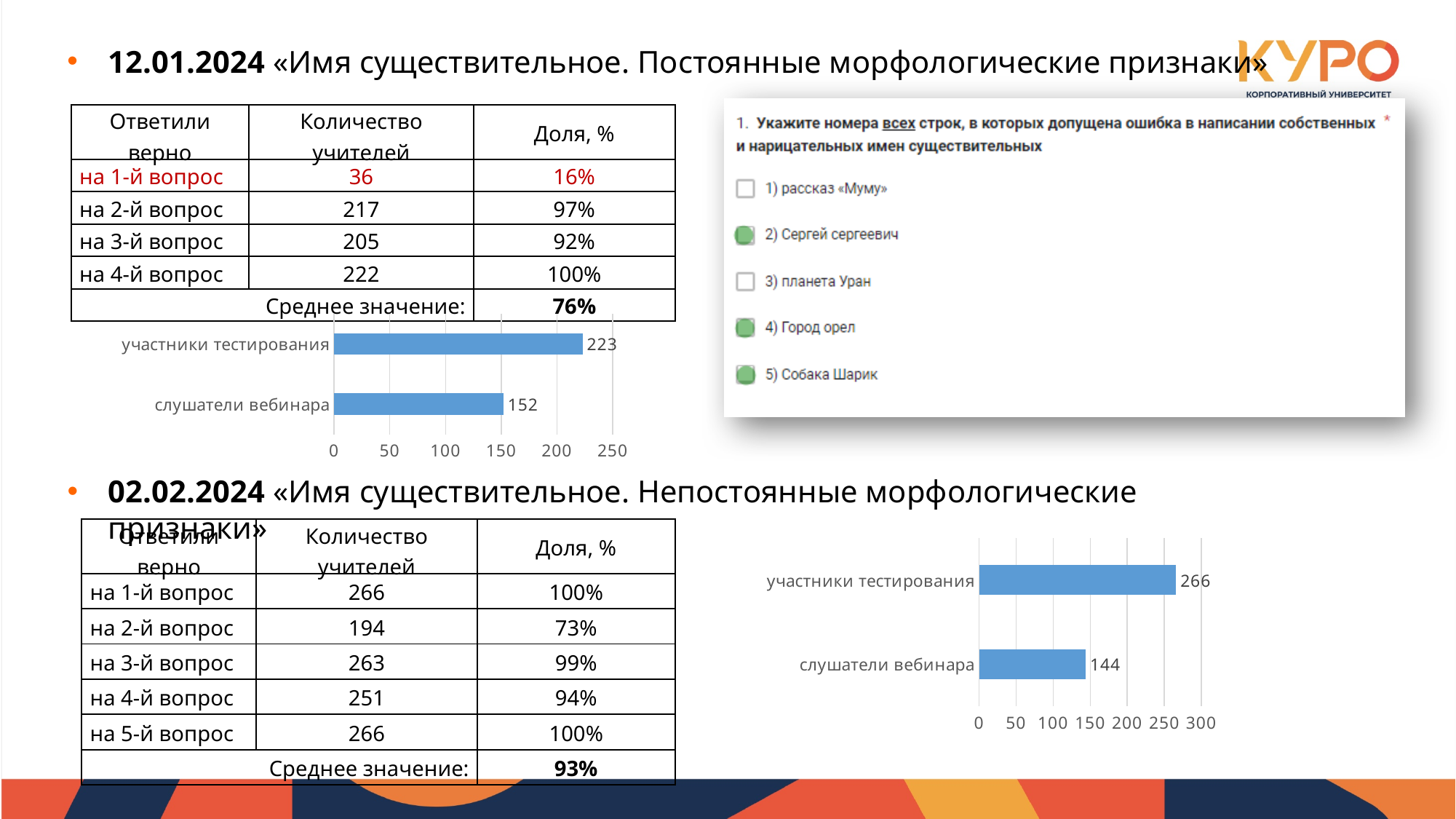
In the bar chart under the 02.02.2024 heading, is the value for участники тестирования greater or less than 250? greater In the bar chart under the 12.01.2024 heading, what is the value for участники тестирования? 223 In the bar chart under the 12.01.2024 heading, which category has the higher value? участники тестирования In the bar chart under the 12.01.2024 heading, what is the difference between участники тестирования and слушатели вебинара? 71 In the bar chart under the 12.01.2024 heading, what is the value for слушатели вебинара? 152 In the bar chart under the 02.02.2024 heading, what is the highest tick shown on the horizontal axis? 300 In the bar chart under the 12.01.2024 heading, how many categories are plotted? 2 In the bar chart under the 02.02.2024 heading, what is the value for слушатели вебинара? 144 In the bar chart under the 02.02.2024 heading, what is the difference between участники тестирования and слушатели вебинара? 122 What type of chart is shown under the 12.01.2024 heading? bar chart In the bar chart under the 02.02.2024 heading, which category has the lower value? слушатели вебинара In the bar chart under the 02.02.2024 heading, what is the value for участники тестирования? 266